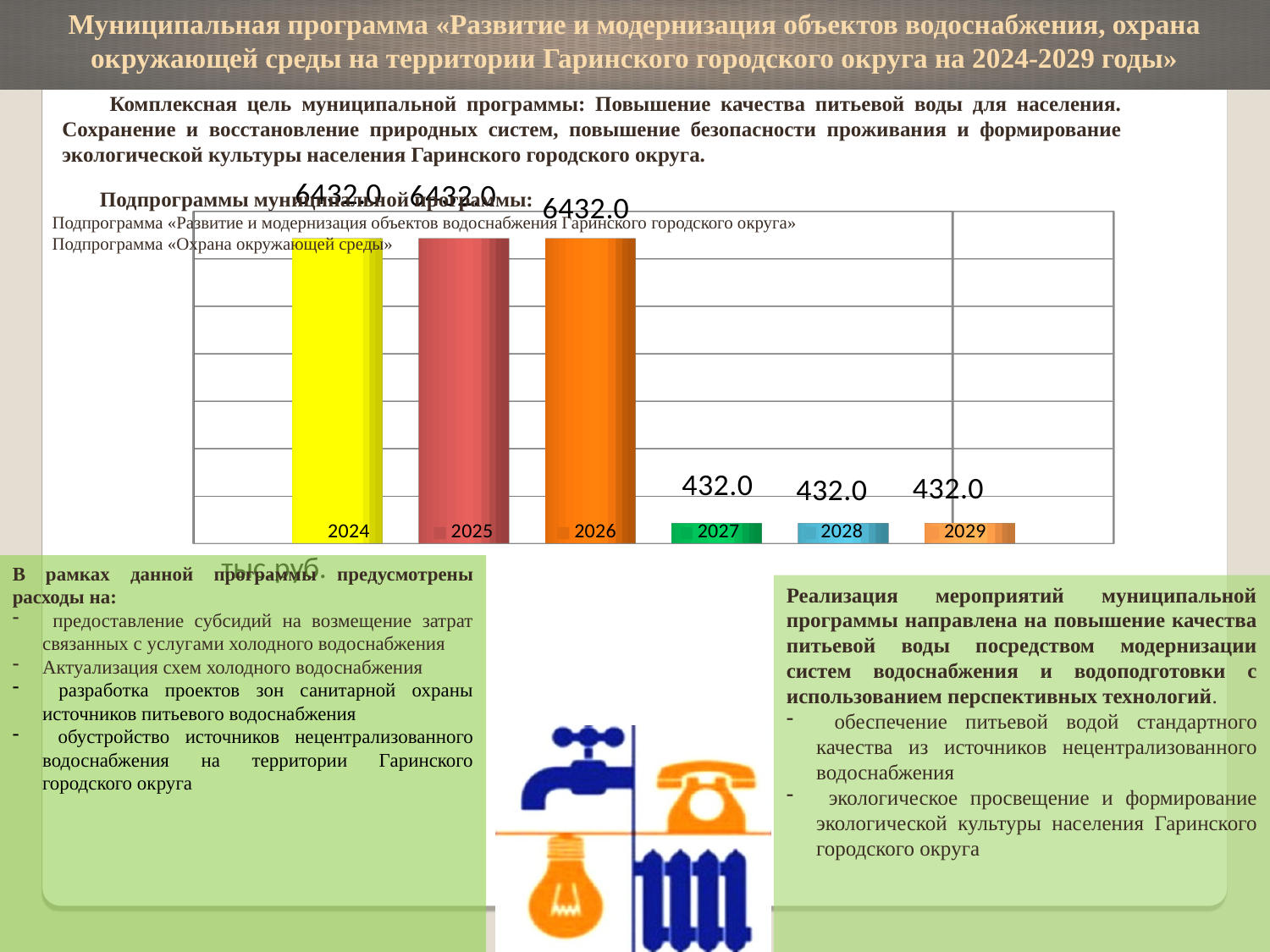
What is the value for 2026 on the chart? 6432.0 What is the total of the values for 2027, 2028 and 2029? 1296.0 What kind of chart is shown on the slide? bar chart What unit is written below the chart? тыс.руб. Do the values rise or fall from 2026 to 2027 on the chart? fall Which is larger, the value for 2025 or the value for 2028? 2025 What colour is the bar for 2024? yellow How many categories (years) are shown on the x axis of the chart? 6 What is the value for 2024 on the chart? 6432.0 What is the value for 2029 on the chart? 432.0 What is the value for 2027 on the chart? 432.0 What is the difference between the values for 2026 and 2027? 6000.0